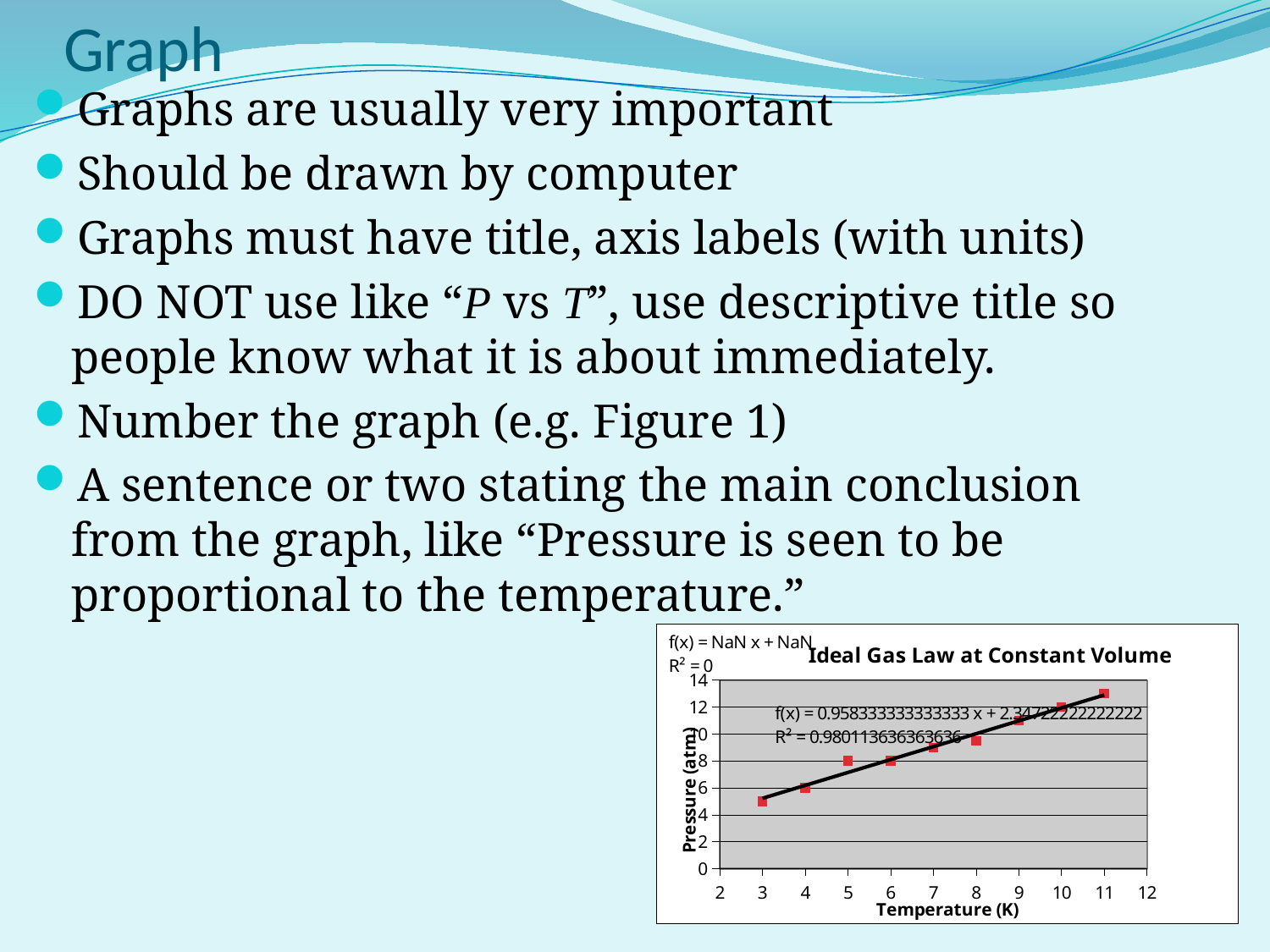
What R² value is printed for the fitted trendline in the chart? 0.980113636363636 Do the pressure values rise or fall as temperature increases along the x axis? rise What kind of chart is shown on the slide? scatter plot Is the pressure value at a temperature of 9 K greater or less than 10? greater What is the title of the chart on the slide? Ideal Gas Law at Constant Volume At which temperature is the plotted pressure highest? 11 What is the label of the x axis of the chart? Temperature (K) At which temperature is the plotted pressure lowest? 3 How many data points are plotted in the chart? 9 Is the pressure value at a temperature of 11 K greater or less than 12? greater Which has the larger pressure value: the point at 4 K or the point at 10 K? 10 K Is the pressure value at a temperature of 3 K greater or less than 6? less